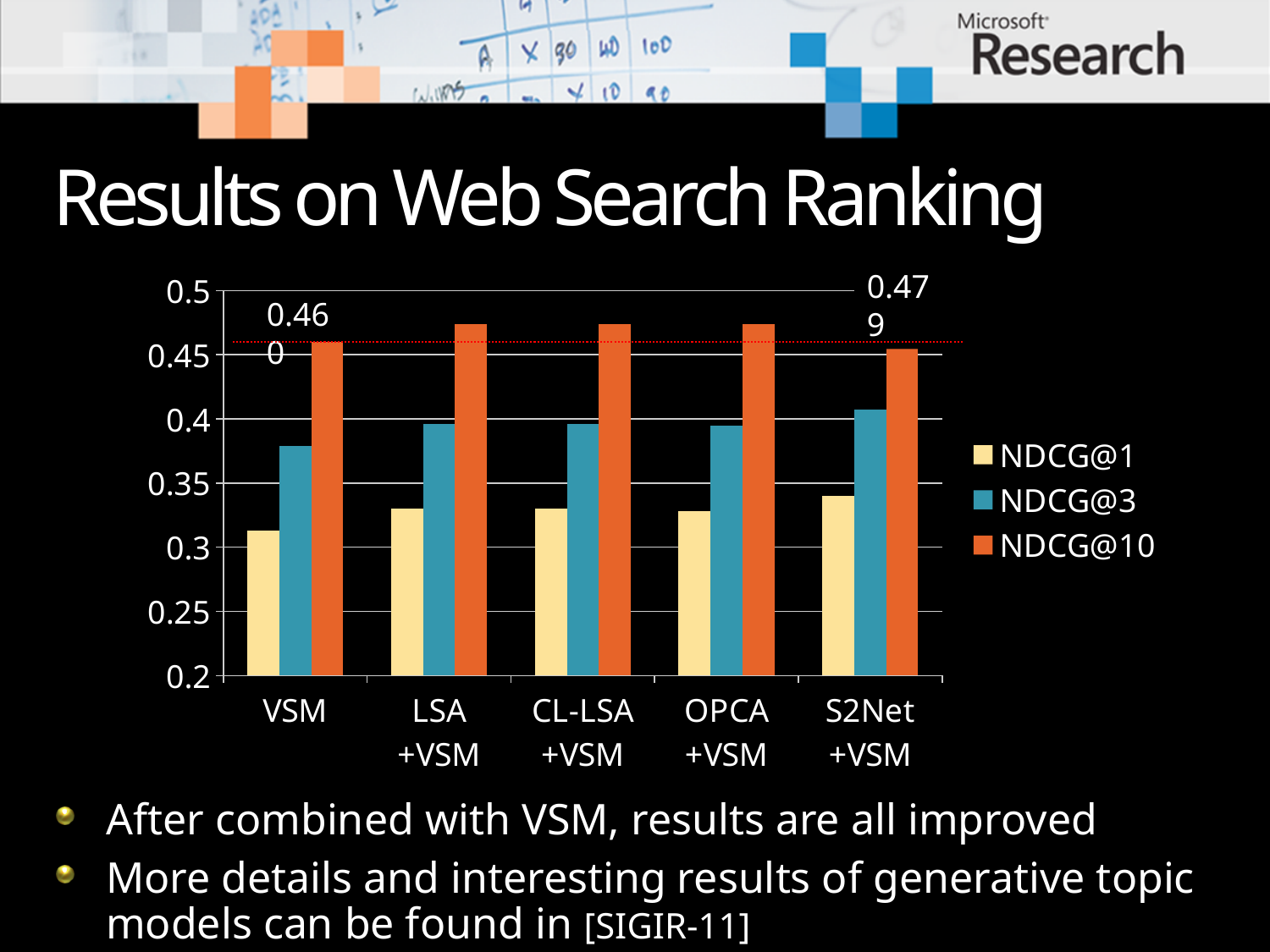
Which has the larger NDCG@3 value: VSM or LSA+VSM? LSA+VSM What kind of chart is shown on the slide? bar chart Is the NDCG@1 value for CL-LSA+VSM greater or less than 0.3? greater How many series does the chart's legend list? 3 What are the series names listed in the chart's legend? NDCG@1, NDCG@3, NDCG@10 Which category has the highest NDCG@3 value? S2Net+VSM How many categories are shown on the x axis of the chart? 5 Is the NDCG@3 value for S2Net+VSM greater or less than 0.4? greater Is the NDCG@10 value for LSA+VSM greater or less than 0.45? greater Which category has the lowest NDCG@1 value? VSM For VSM, which is larger: the NDCG@1 value or the NDCG@10 value? NDCG@10